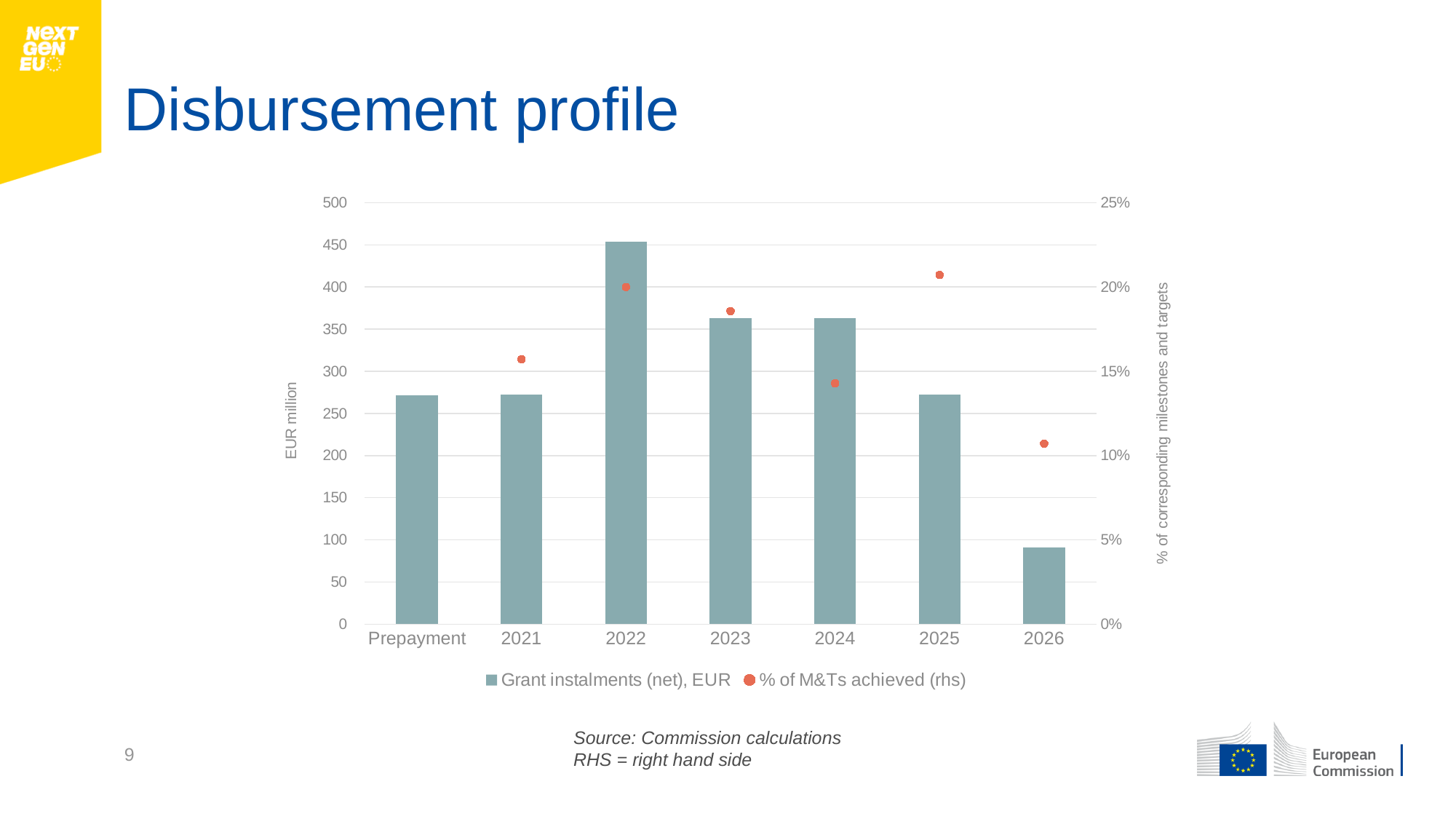
How many categories are shown on the x axis? 7 Is the % of M&Ts achieved for 2021 greater or less than 15%? greater How many series does the legend list? 2 Which category has the highest grant instalment bar? 2022 In which year is the % of M&Ts achieved (rhs) dot the lowest? 2026 Which has the larger grant instalment bar, Prepayment or 2026? Prepayment Is the grant instalment value for 2026 greater or less than 100? less Which category has the lowest grant instalment bar? 2026 Is the grant instalment value for 2022 greater or less than 400? greater Which has the larger grant instalment bar, 2022 or 2023? 2022